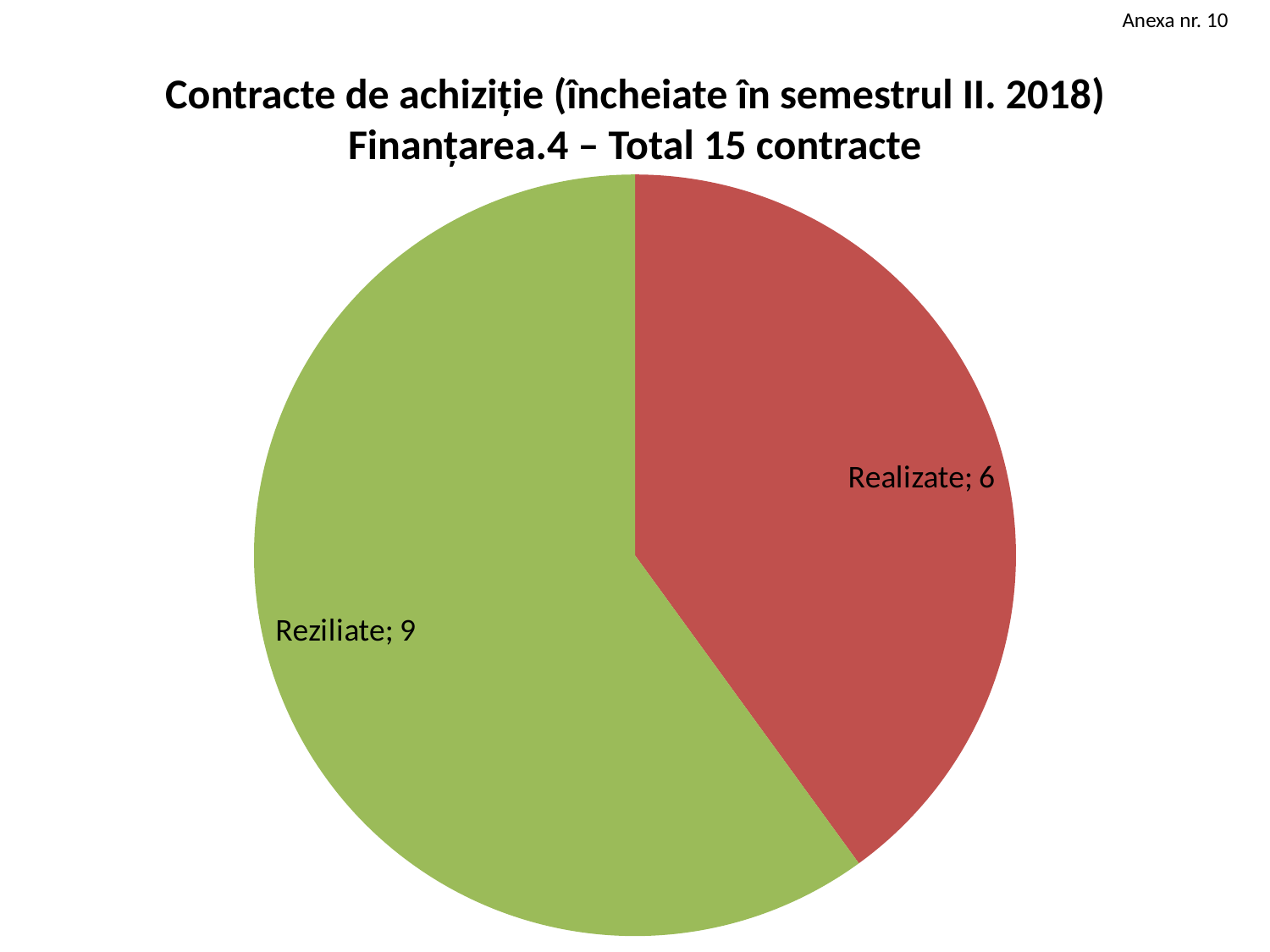
How many contracts are labelled as Realizate? 6 What kind of chart is shown on the slide? Pie chart What is the total number of contracts shown in the pie chart? 15 Which category has the smaller slice of the pie? Realizate What share of the pie does the Reziliate slice represent? 60% How many contracts are labelled as Reziliate? 9 What is the difference between the number of Reziliate and Realizate contracts? 3 What share of the pie does the Realizate slice represent? 40% Which category has the larger slice of the pie? Reziliate What colour is the Reziliate slice? Green How many slices does the pie chart have? 2 Which is larger: the value for Realizate or the value for Reziliate? Reziliate